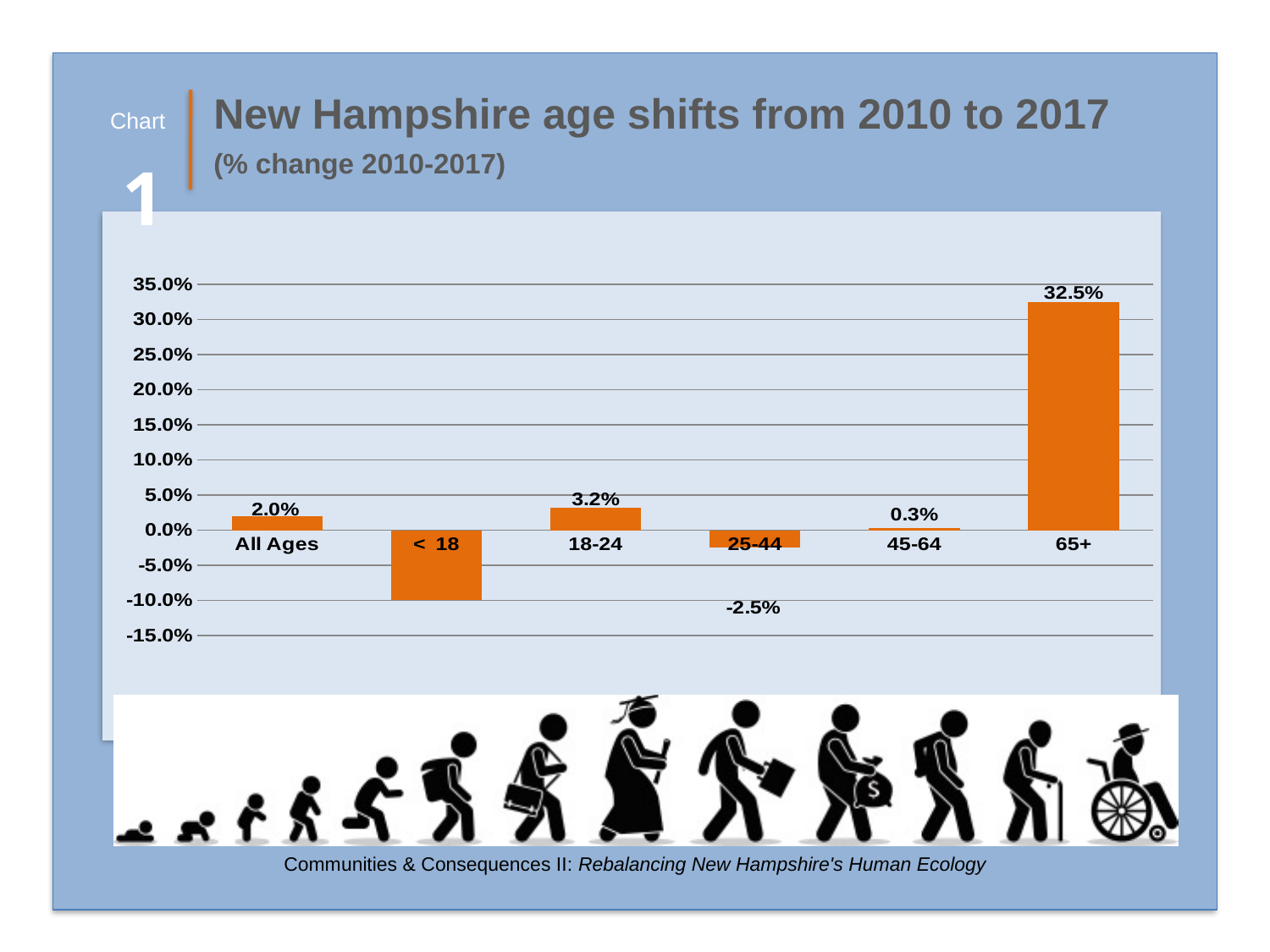
What is the value for the 25-44 age group? -2.5% Which is larger, the value for All Ages or the value for 45-64? All Ages Is the value for the < 18 age group greater or less than -5.0%? less What is the value for the 45-64 age group? 0.3% How many age categories are shown on the chart? 6 What is the difference between the values for 65+ and 18-24? 29.3 percentage points Which age group has the highest percentage change? 65+ Which age group has the lowest percentage change? < 18 What is the value for All Ages? 2.0% What is the value for the 65+ age group? 32.5% What type of chart is shown on the slide? Bar chart What is the value for the 18-24 age group? 3.2%